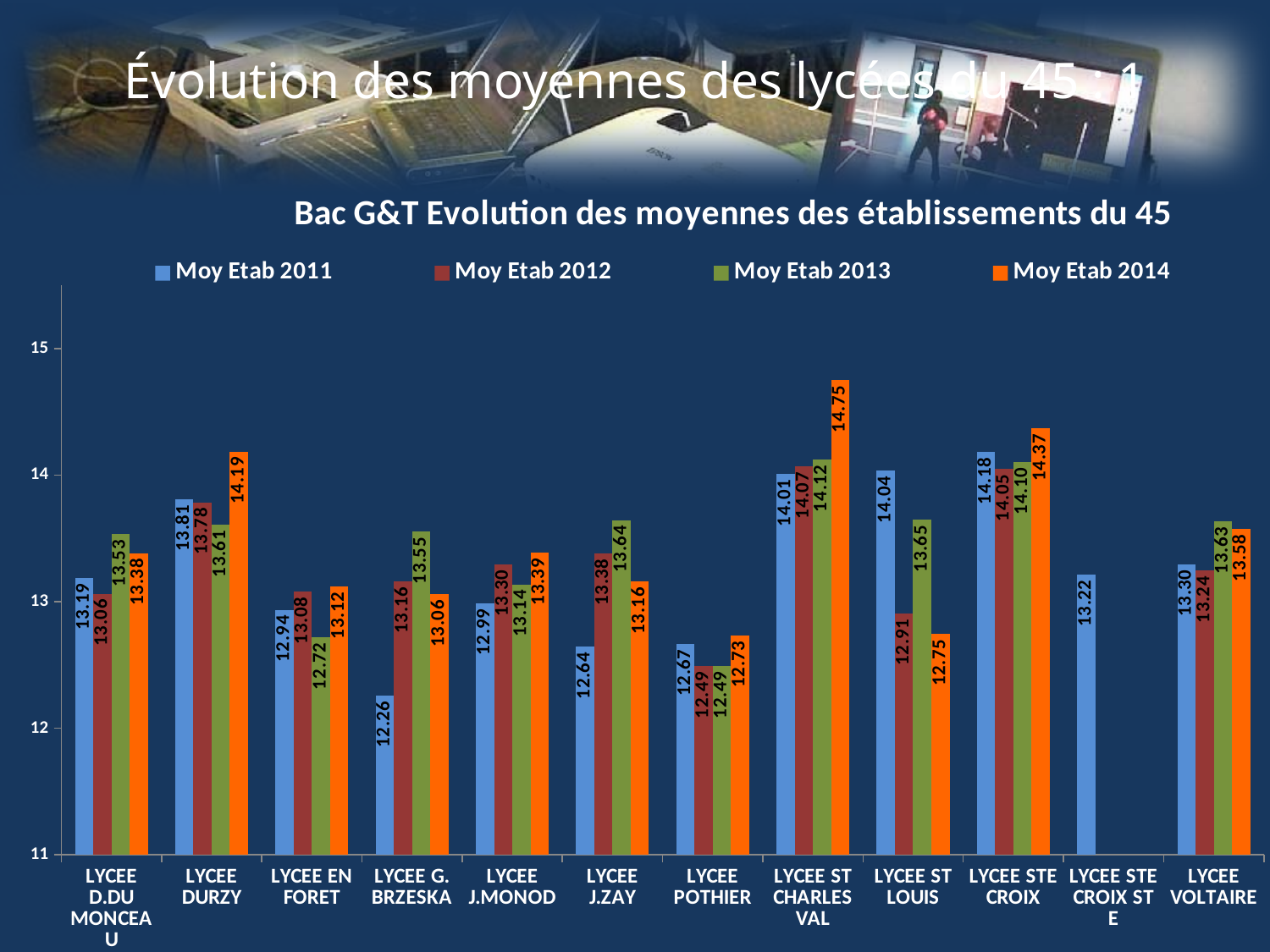
What is the Moy Etab 2013 value for LYCEE J.ZAY? 13.64 Do the values for LYCEE ST CHARLES VAL rise or fall from Moy Etab 2011 to Moy Etab 2014? Rise What is the Moy Etab 2011 value for LYCEE G. BRZESKA? 12.26 What is the difference between the Moy Etab 2014 and Moy Etab 2011 values for LYCEE DURZY? 0.38 What is the title of the chart? Bac G&T Evolution des moyennes des établissements du 45 What is the Moy Etab 2014 value for LYCEE ST CHARLES VAL? 14.75 Which is larger for LYCEE ST LOUIS: the Moy Etab 2011 value or the Moy Etab 2014 value? Moy Etab 2011 Which lycée has the lowest Moy Etab 2011 value? LYCEE G. BRZESKA Which lycée has the highest Moy Etab 2014 value? LYCEE ST CHARLES VAL What kind of chart is shown on the slide? Bar chart How many series does the legend list? 4 How many lycées are shown on the x axis? 12